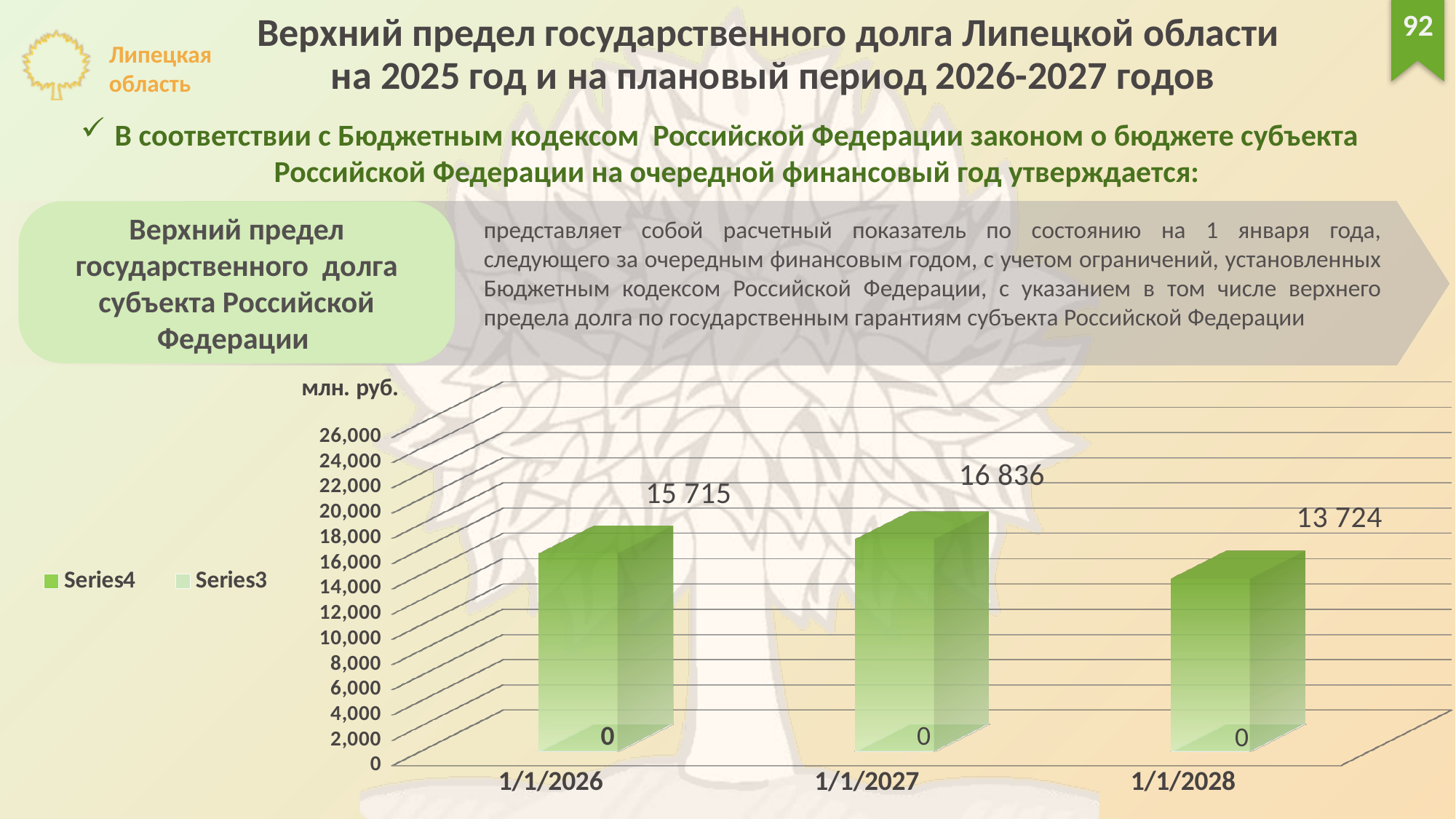
What is the value shown for 1/1/2028? 13 724 What is the value shown for 1/1/2027? 16 836 What is the difference between the values for 1/1/2027 and 1/1/2026? 1 121 Which date has the highest value? 1/1/2027 How many dates are shown on the x axis of the chart? 3 What is the difference between the values for 1/1/2026 and 1/1/2028? 1 991 What kind of chart is shown on the slide? bar chart Which is larger, the value for 1/1/2026 or the value for 1/1/2028? 1/1/2026 What is the value shown for 1/1/2026? 15 715 What unit is indicated on the vertical axis of the chart? млн. руб. Which date has the lowest value? 1/1/2028 How many series does the chart legend list? 2